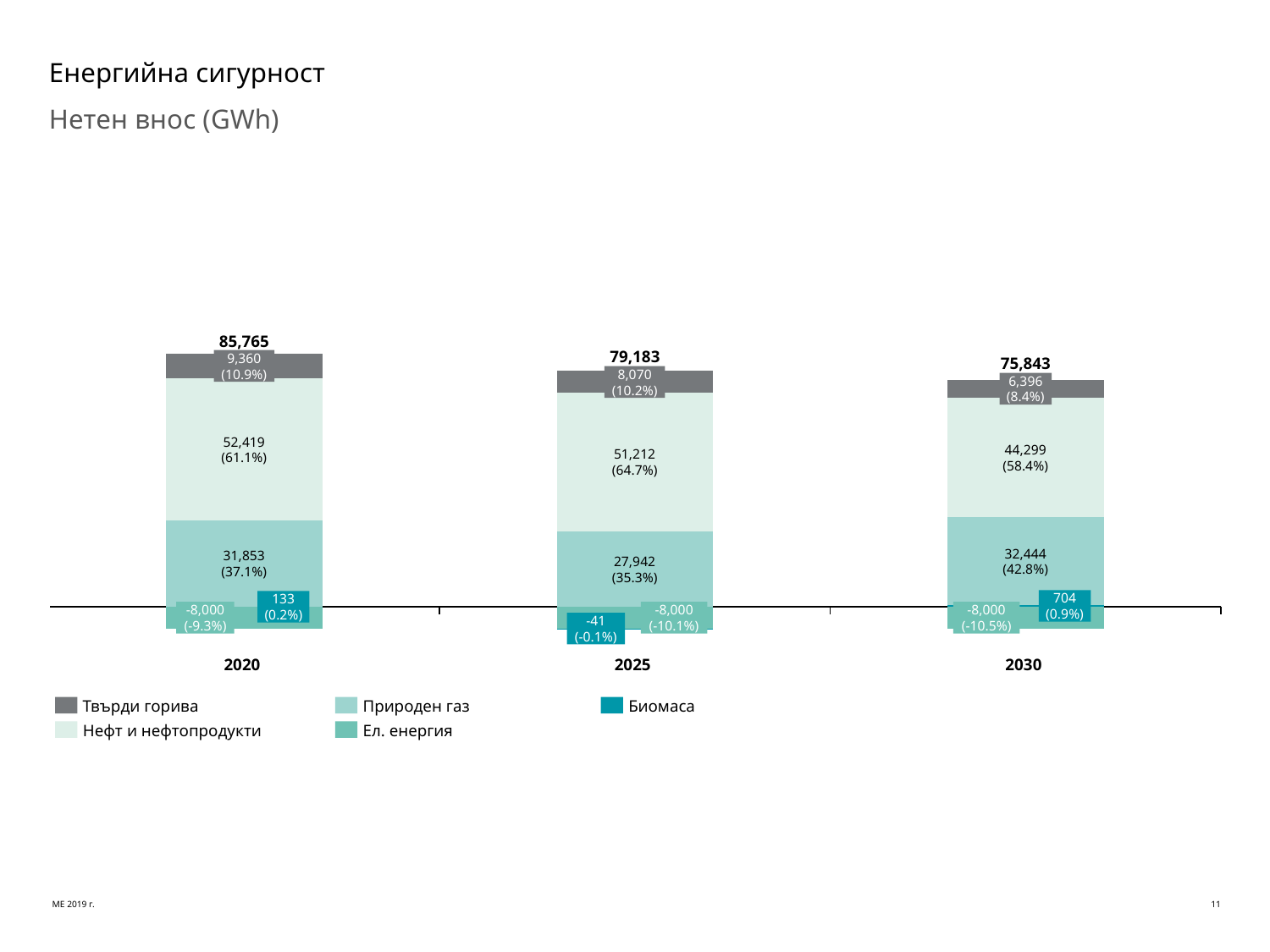
What percentage share is shown for Ел. енергия in 2030? -10.5% Which year has the highest total net import? 2020 Is the value of Природен газ larger in 2020 or in 2025? 2020 What is the value of Твърди горива in 2020? 9,360 What is the value of Природен газ in 2030? 32,444 What is the value of Нефт и нефтопродукти in 2025? 51,212 Do the total net import values rise or fall from 2020 to 2030? fall How many series does the legend list? 5 What is the total net import shown above the 2020 bar? 85,765 How many years are shown on the x axis? 3 What is the difference between the Твърди горива values in 2020 and 2030? 2,964 Which year has the lowest total net import? 2030